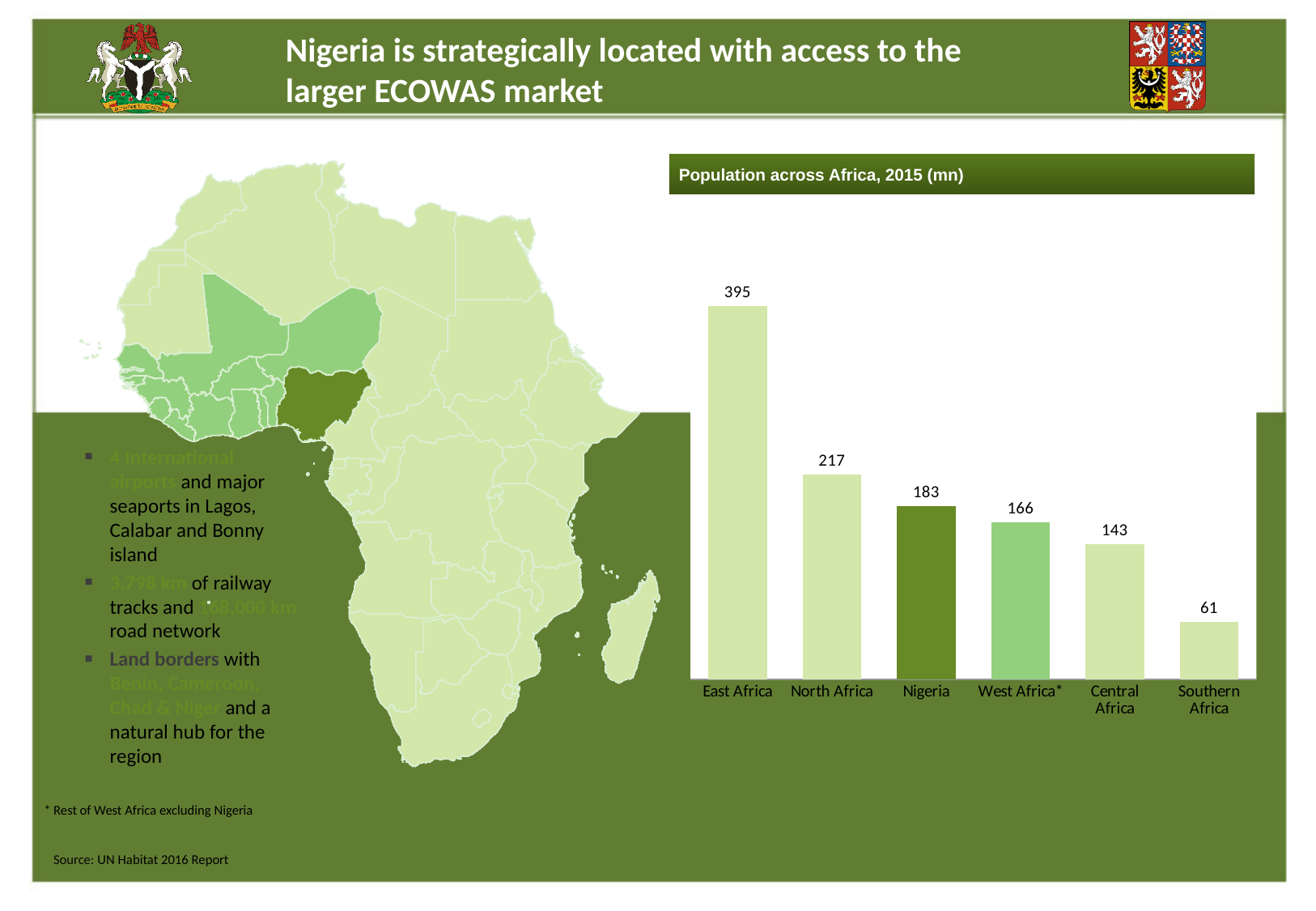
What is the population value shown for East Africa? 395 Which has a larger population value, Central Africa or West Africa*? West Africa* What is the population value shown for Nigeria? 183 What is the difference between the population values for Nigeria and West Africa*? 17 Which bar in the chart is shaded the darkest green? Nigeria Which category has the lowest population in the chart? Southern Africa Which category has the highest population in the chart? East Africa What is the difference between the population values for East Africa and North Africa? 178 What is the title of the chart? Population across Africa, 2015 (mn) What type of chart is used to show population across Africa? Bar chart What is the population value shown for Southern Africa? 61 How many categories are shown in the bar chart? 6